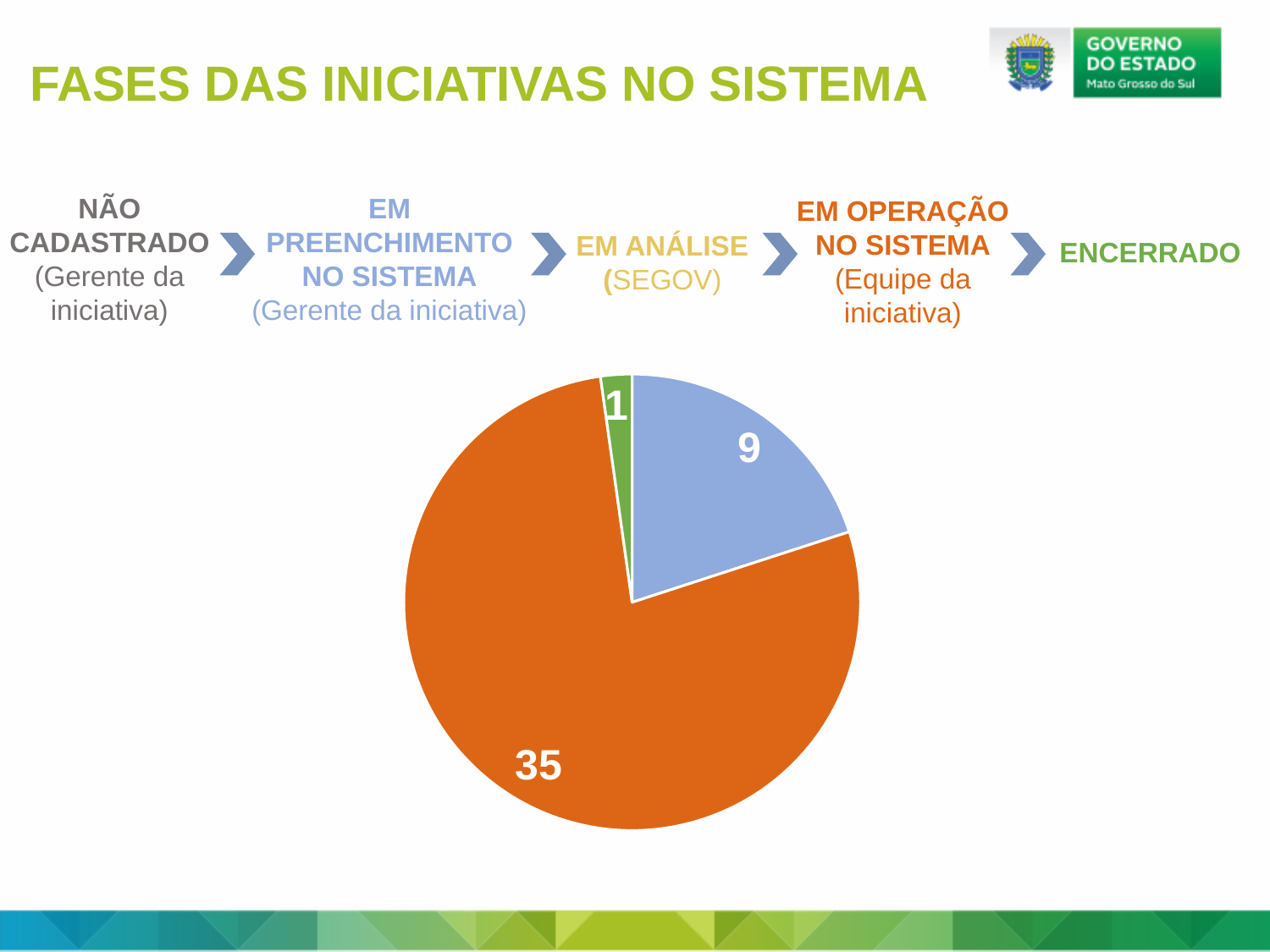
What is the total of all the values shown in the pie chart? 45 What is the difference between the orange slice and the blue slice in the pie chart? 26 Which is larger in the pie chart, the blue slice or the green slice? the blue slice Which slice of the pie chart has the lowest value? the green slice (1) What kind of chart is shown on the slide? pie chart How many slices does the pie chart have? 3 What value is shown on the orange slice of the pie chart? 35 What is the difference between the blue slice and the green slice in the pie chart? 8 What share of the pie chart total does the blue slice (9) represent? 20% What value is shown on the green slice of the pie chart? 1 Which slice of the pie chart has the highest value? the orange slice (35) What value is shown on the blue slice of the pie chart? 9